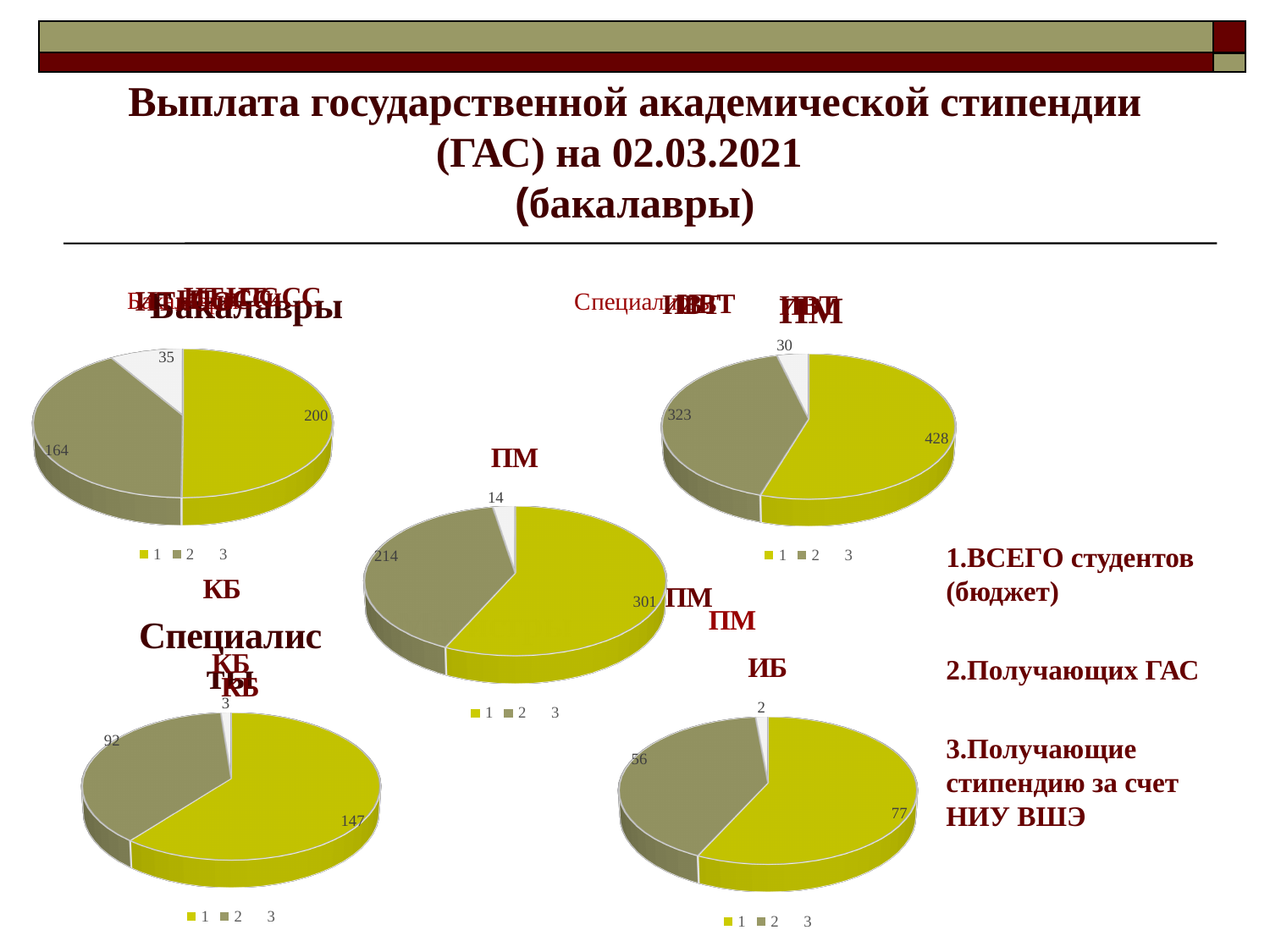
In the top-right pie chart, which slice has the largest value? 1 In the top-right pie chart, what is the value of slice 1? 428 In the top-left pie chart, what is the difference between slice 1 and slice 2? 36 How many slices does the pie chart labelled ИБ have? 3 How many entries does the legend of the top-left pie chart list? 3 Which is larger: slice 1 in the bottom-left pie chart or slice 1 in the pie chart labelled ИБ? Slice 1 in the bottom-left pie chart In the pie chart labelled ПМ in the centre of the slide, what is the value of slice 1? 301 In the pie chart labelled ИБ at the bottom right, what is the value of slice 2? 56 In the pie chart labelled ПМ in the centre, what is the difference between slice 1 and slice 2? 87 In the bottom-left pie chart, which slice has the smallest value? 3 What type of chart is used for the chart labelled ПМ in the centre of the slide? Pie chart In the top-left pie chart, what is the value of slice 3? 35